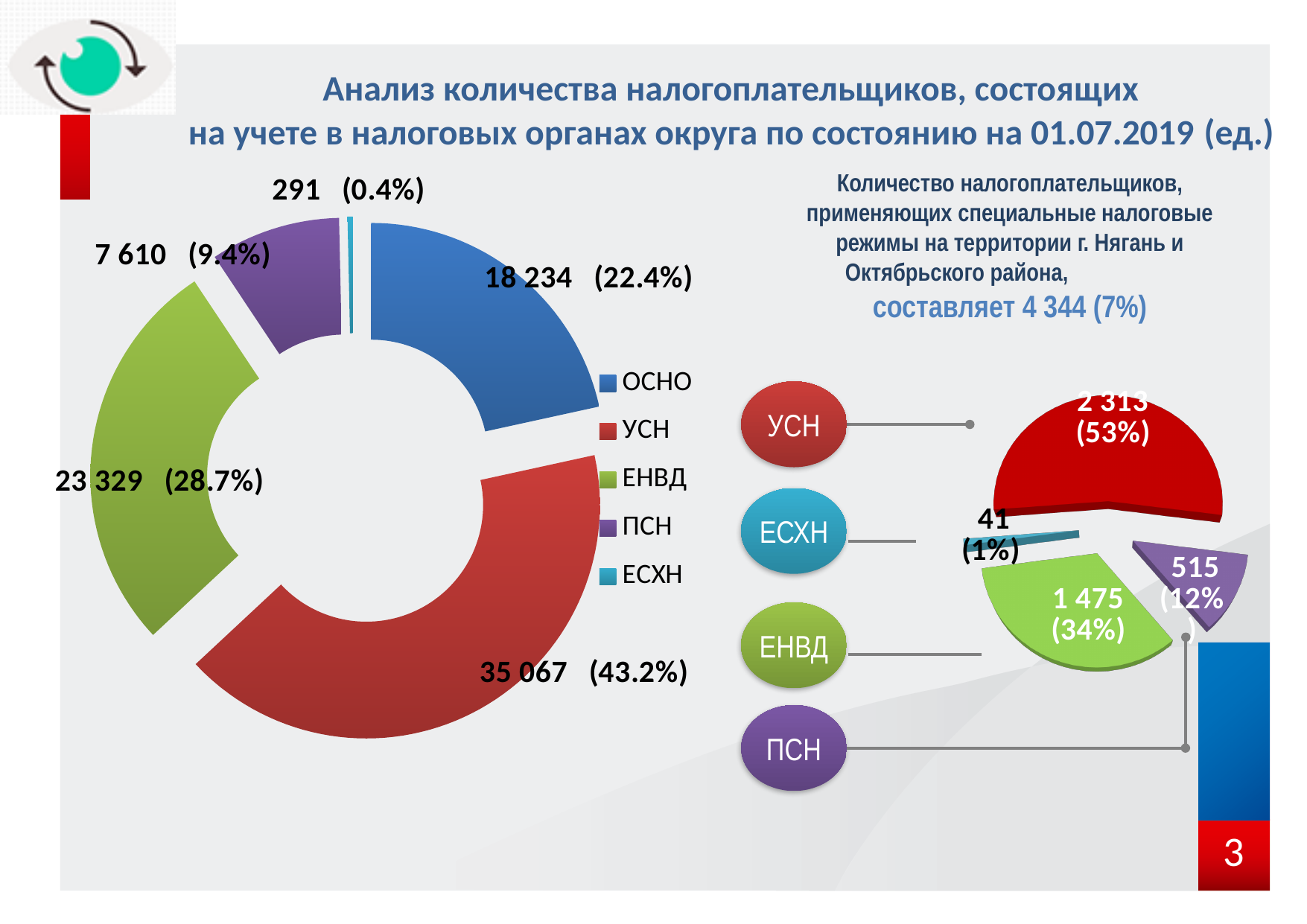
On the right pie chart, which is larger, the value for ЕНВД or the value for ПСН? ЕНВД On the left doughnut chart, what is the value for ПСН? 7 610 On the left doughnut chart, which category has the smallest value? ЕСХН On the right pie chart, what is the value for ЕНВД? 1 475 On the left doughnut chart, what is the difference between the values for УСН and ОСНО? 16 833 On the right pie chart, which category has the largest value? УСН What type of chart is shown on the left of the slide? Doughnut chart On the left doughnut chart, what is the value for УСН? 35 067 On the left doughnut chart, which category has the largest value? УСН On the right pie chart, what percentage share is shown for ПСН? 12% On the left doughnut chart, how many categories does the legend list? 5 On the left doughnut chart, what percentage share is shown for ЕНВД? 28.7%